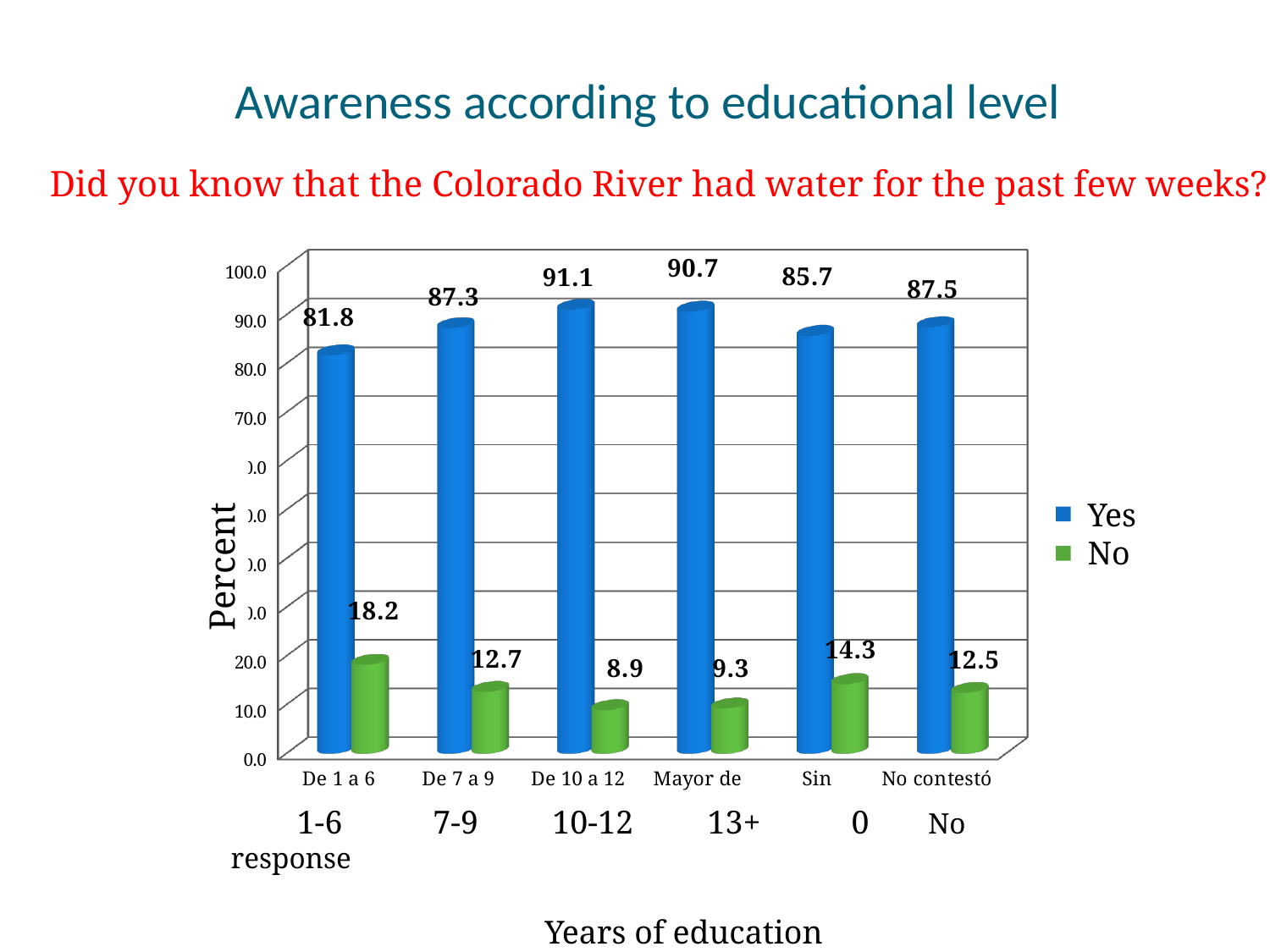
How many series does the legend list? 2 What is the 'Yes' value for the 10-12 years of education category? 91.1 What is the 'Yes' value for the 'Sin' (0 years of education) category? 85.7 What is the 'No' value for the 1-6 years of education category? 18.2 What is the difference between the 'Yes' and 'No' values for the 7-9 years category? 74.6 What is the 'No' value for the 'No contestó' (No response) category? 12.5 Which category has the lowest 'No' value? De 10 a 12 (10-12) Which category has the lowest 'Yes' value? De 1 a 6 (1-6) How many education categories are shown on the x axis? 6 What type of chart is shown on the slide? Bar chart Is the 'No' value for the 13+ category larger or smaller than the 'No' value for the 'Sin' (0) category? smaller Which category has the highest 'Yes' value? De 10 a 12 (10-12)